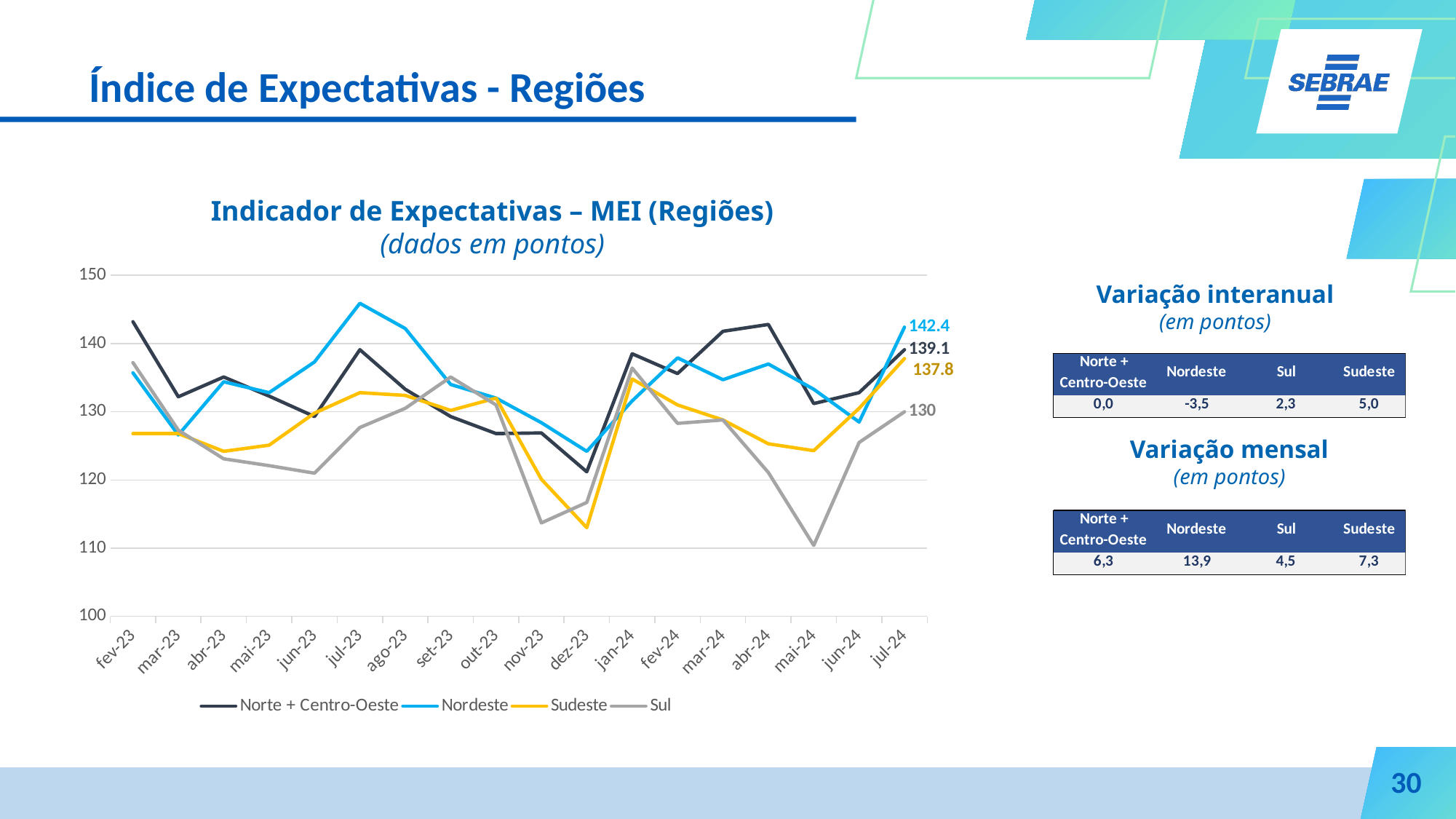
How many series does the chart legend list? 4 What is the value for Norte + Centro-Oeste in jul-24? 139.1 What is the value for Sul in jul-24? 130 What is the value for Nordeste in jul-24? 142.4 What kind of chart is shown on the slide? line chart Is the value for Nordeste in jul-23 greater or less than 140? greater Is the value for Sul in mai-24 greater or less than 120? less Which region has the highest value in jul-24? Nordeste What is the difference between the Nordeste and Sul values in jul-24? 12.4 How many months are plotted along the x axis of the chart? 18 What is the value for Sudeste in jul-24? 137.8 Which region has the lowest value in jul-24? Sul